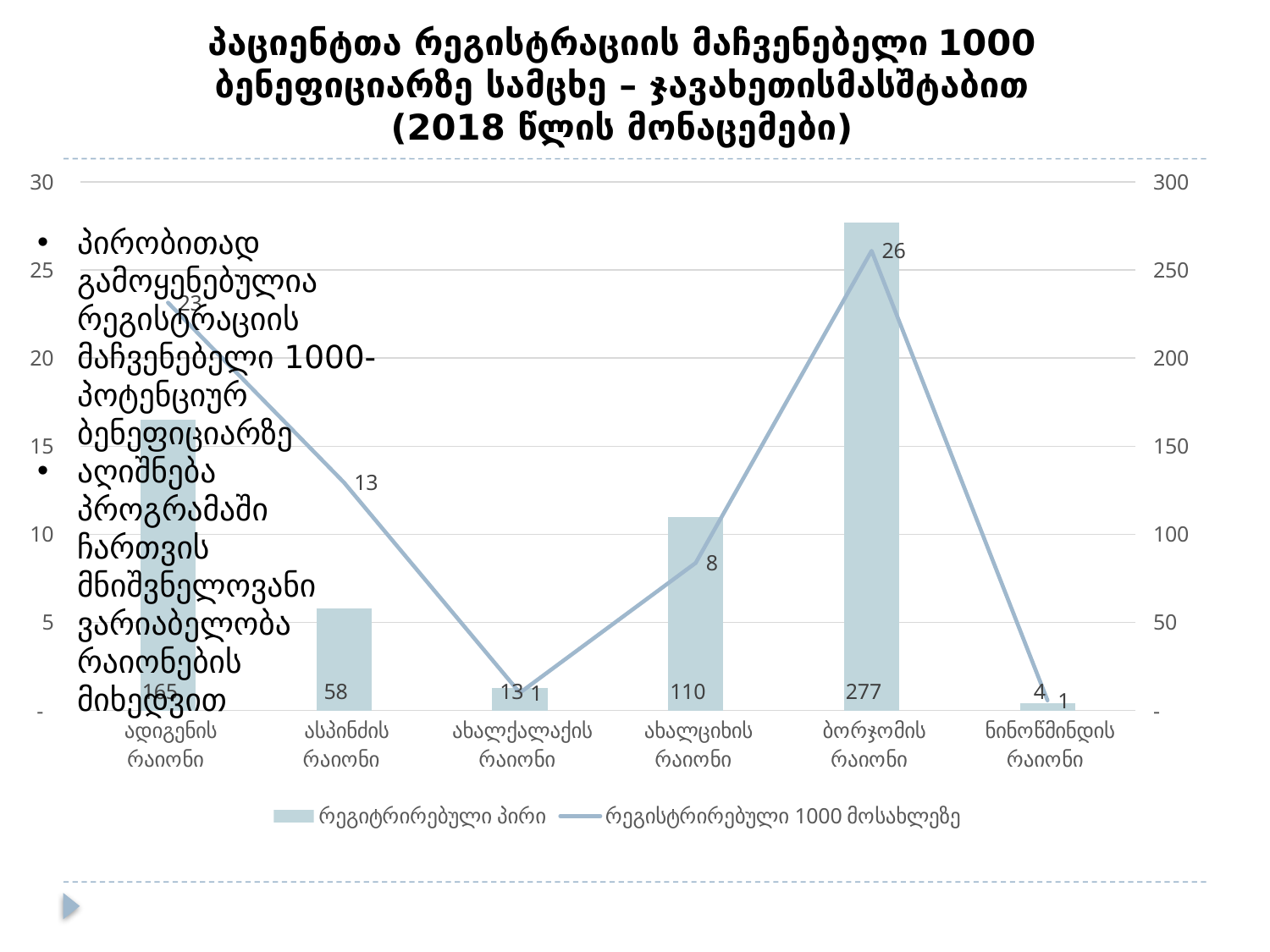
Which category has the lowest value of რეგიტრირებული პირი? ნინოწმინდის რაიონი What is the value of რეგიტრირებული პირი for ახალქალაქის რაიონი? 13 How many series does the legend list? 2 What is the value of რეგისტრირებული 1000 მოსახლეზე for ახალციხის რაიონი? 8 What is the value of რეგიტრირებული პირი for ასპინძის რაიონი? 58 What is the value of რეგიტრირებული პირი for ბორჯომის რაიონი? 277 Which is larger, the რეგისტრირებული 1000 მოსახლეზე value for ასპინძის რაიონი or for ახალციხის რაიონი? ასპინძის რაიონი What is the difference between the რეგიტრირებული პირი values for ბორჯომის რაიონი and ადიგენის რაიონი? 112 What is the value of რეგისტრირებული 1000 მოსახლეზე for ადიგენის რაიონი? 23 How many categories are shown on the x axis? 6 Which category has the highest value of რეგიტრირებული პირი? ბორჯომის რაიონი What kind of chart is shown on the slide? Combined bar and line chart